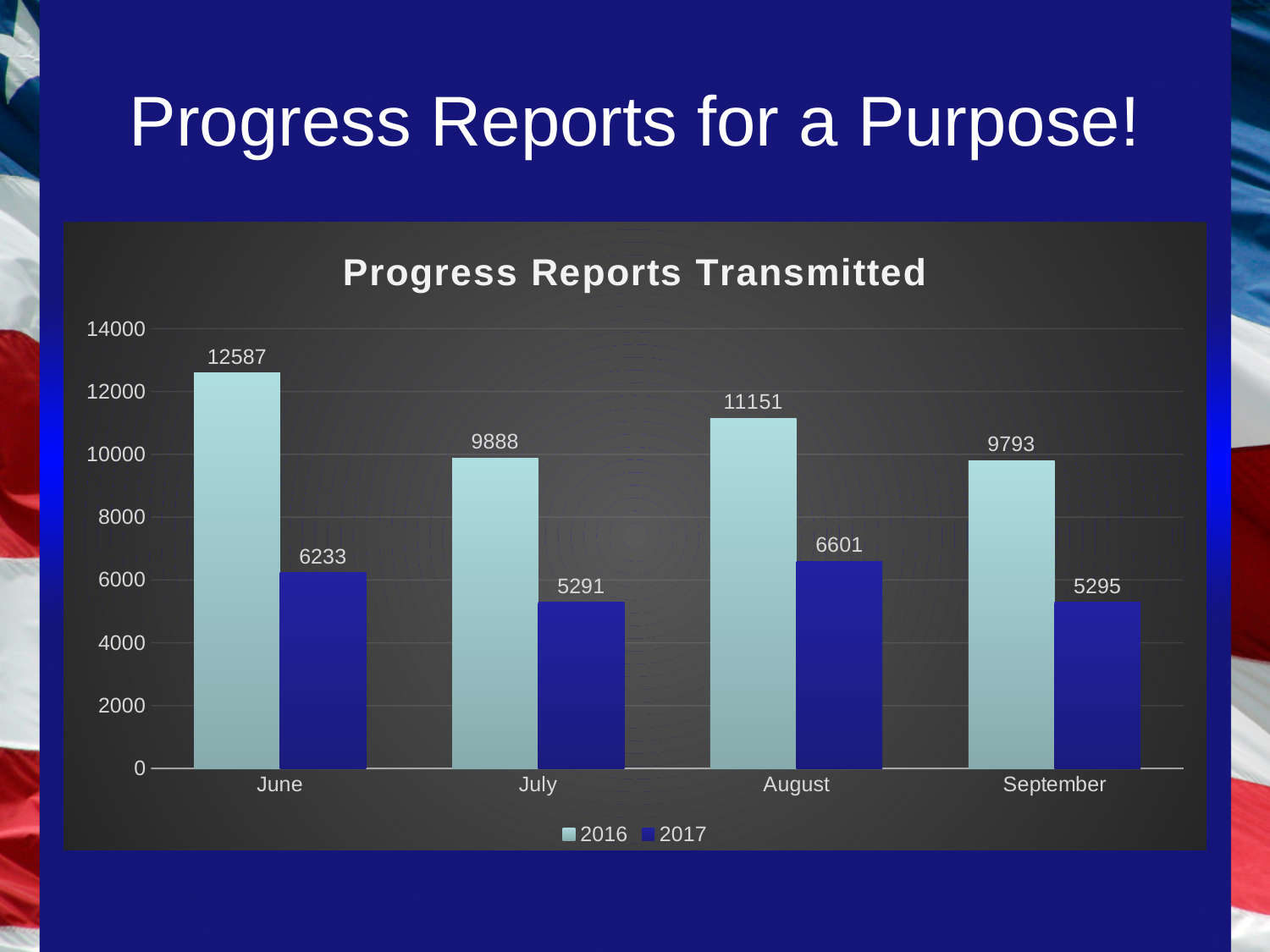
What is the title of the chart? Progress Reports Transmitted How many series does the legend list? 2 Which is larger, the 2017 value for June or the 2017 value for August? August Which month has the lowest value for 2017? July What is the value for 2016 in June? 12587 What kind of chart is shown? Bar chart What is the value for 2017 in August? 6601 What is the difference between the 2016 and 2017 values in June? 6354 Which month has the highest value for 2016? June What is the value for 2017 in September? 5295 How many months are shown on the x axis? 4 What is the difference between the 2016 values for August and September? 1358